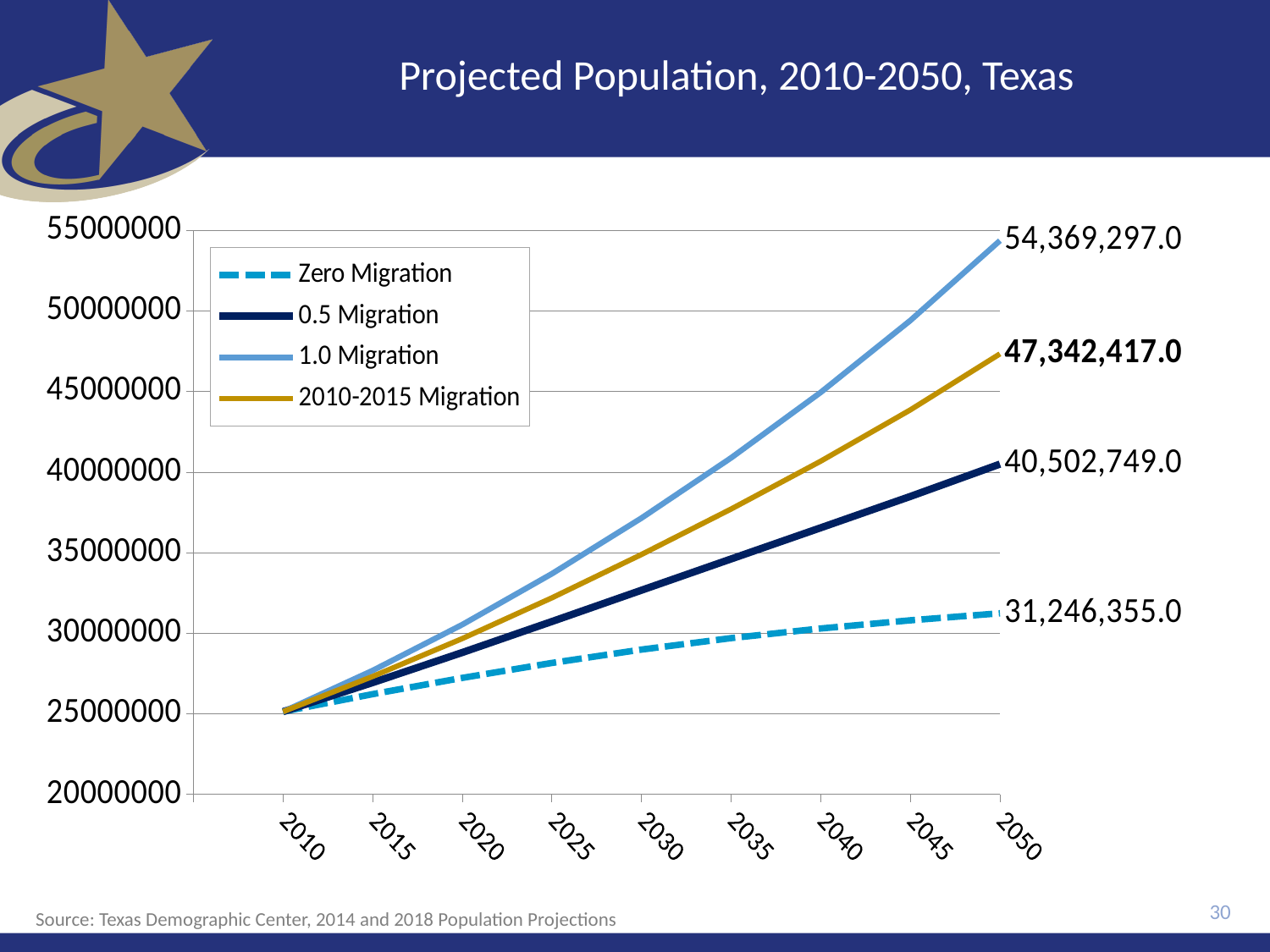
What is the projected population in 2050 under the 0.5 Migration scenario? 40,502,749.0 What is the title of the chart? Projected Population, 2010-2050, Texas How many years are labelled on the x axis? 9 How many series does the legend list? 4 What type of chart is shown on the slide? line chart What is the projected population in 2050 under the Zero Migration scenario? 31,246,355.0 What is the projected population in 2050 under the 2010-2015 Migration scenario? 47,342,417.0 Which scenario has the lowest projected population in 2050? Zero Migration What is the projected population in 2050 under the 1.0 Migration scenario? 54,369,297.0 Which scenario has the highest projected population in 2050? 1.0 Migration What is the difference between the 2050 values for the 1.0 Migration and Zero Migration scenarios? 23,122,942.0 Is the Zero Migration value for 2030 greater or less than 30000000? less